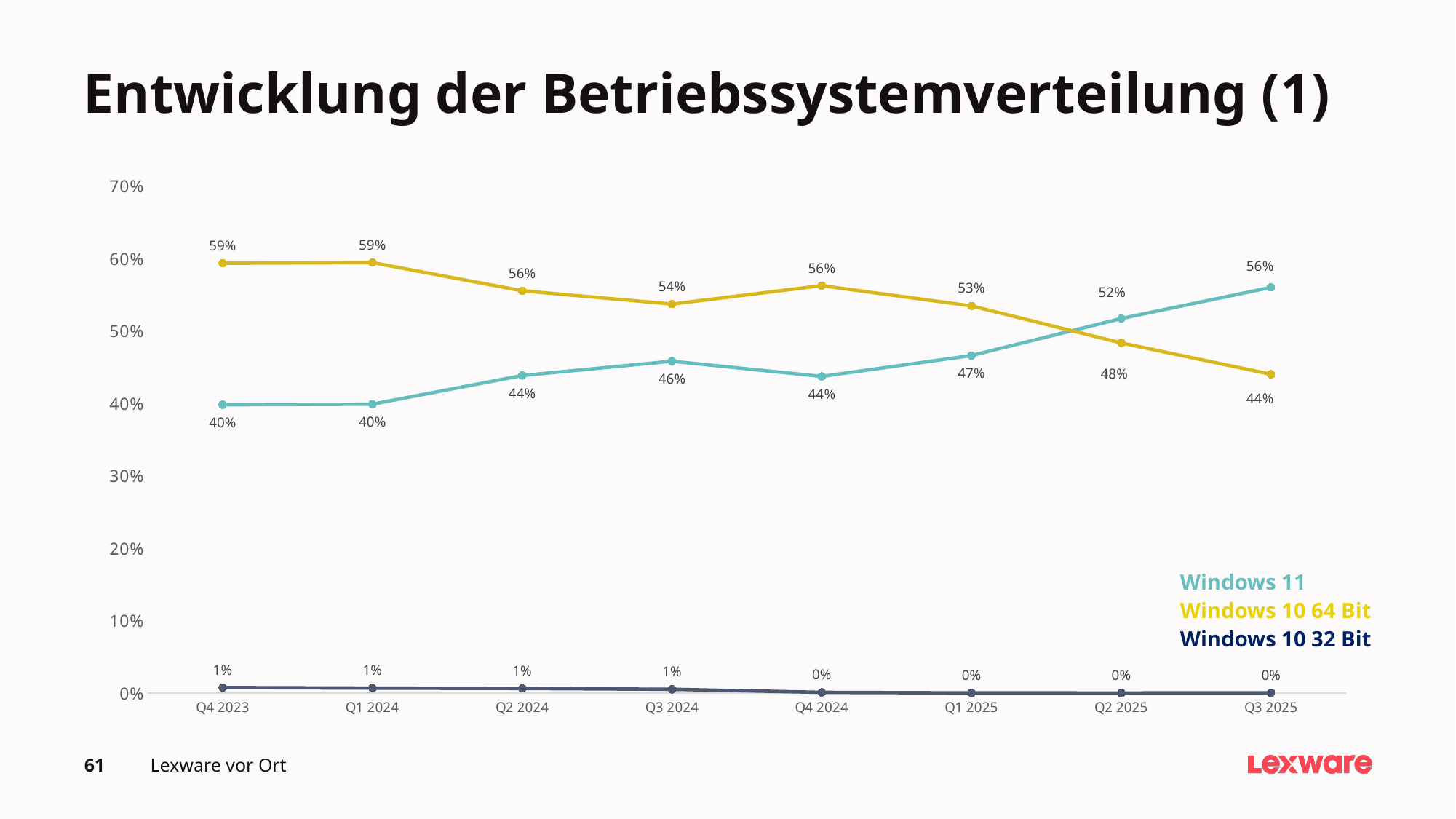
In which quarter does Windows 10 64 Bit reach its lowest value? Q3 2025 In which quarter does Windows 11 reach its highest value? Q3 2025 Which is larger in Q2 2025, Windows 11 or Windows 10 64 Bit? Windows 11 How many quarters are plotted along the x axis? 8 What is the value for Windows 11 in Q3 2025? 56% How many series does the legend list? 3 What is the value for Windows 10 64 Bit in Q4 2023? 59% What is the value for Windows 10 32 Bit in Q2 2024? 1% Which colour is used for the Windows 10 64 Bit line? yellow Does the Windows 11 line generally rise or fall from Q4 2023 to Q3 2025? rise What is the difference between Windows 10 64 Bit and Windows 11 in Q4 2023? 19% What type of chart is shown on the slide? line chart